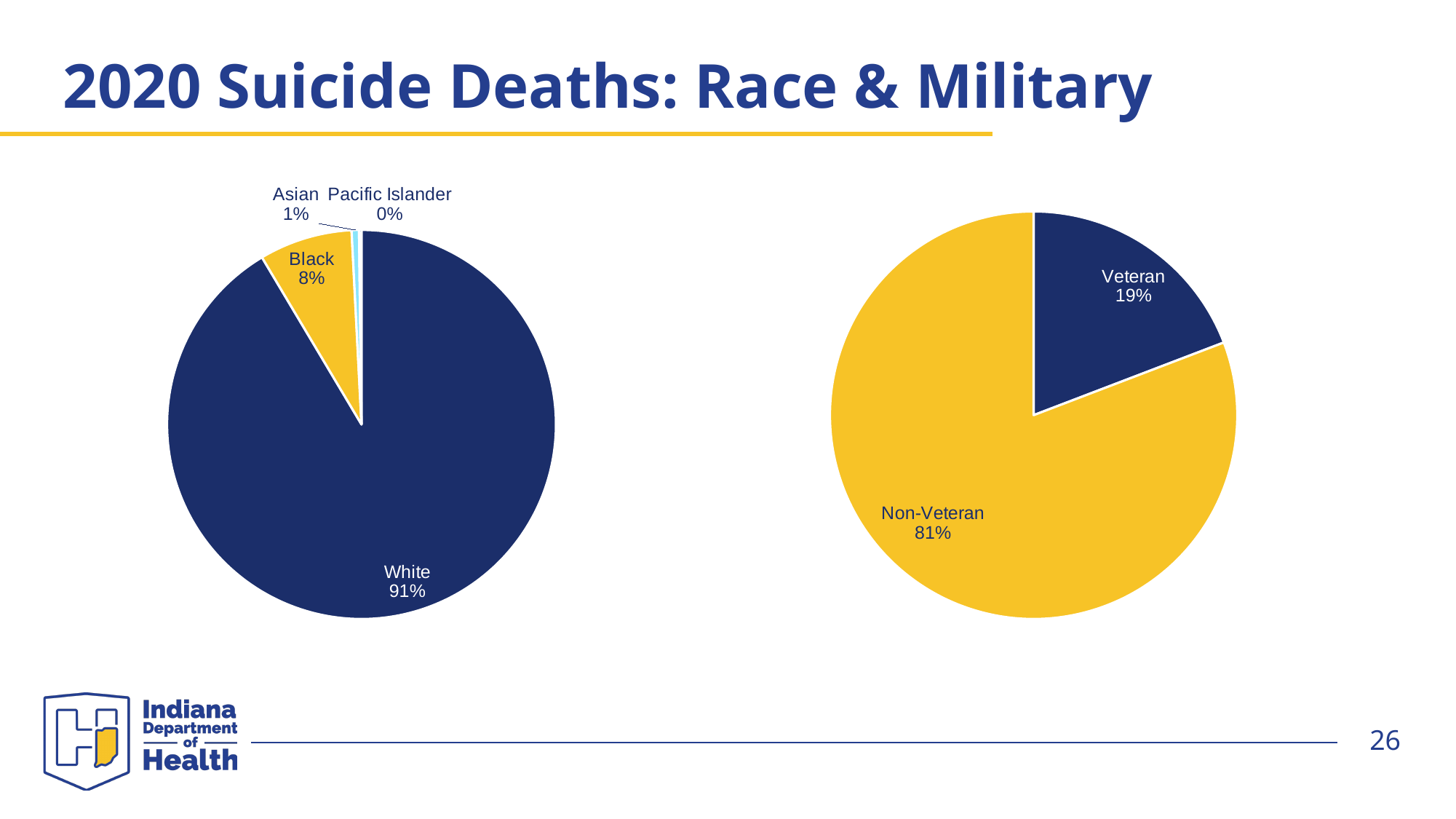
In the left pie chart (race), what percentage is shown for Asian? 1% In the left pie chart (race), what is the difference in percentage points between White and Black? 83 In the left pie chart (race), how many categories are shown? 4 In the right pie chart (military), what percentage is shown for Veteran? 19% In the left pie chart (race), what percentage is shown for Pacific Islander? 0% In the left pie chart (race), which category has the smallest slice? Pacific Islander In the left pie chart (race), what percentage is shown for Black? 8% In the left pie chart (race), what share of suicide deaths is labelled for White? 91% What kind of chart is used on the right side of the slide? Pie chart In the right pie chart (military), what share is labelled for Non-Veteran? 81% In the right pie chart (military), which is larger, Veteran or Non-Veteran? Non-Veteran In the left pie chart (race), which category has the largest slice? White